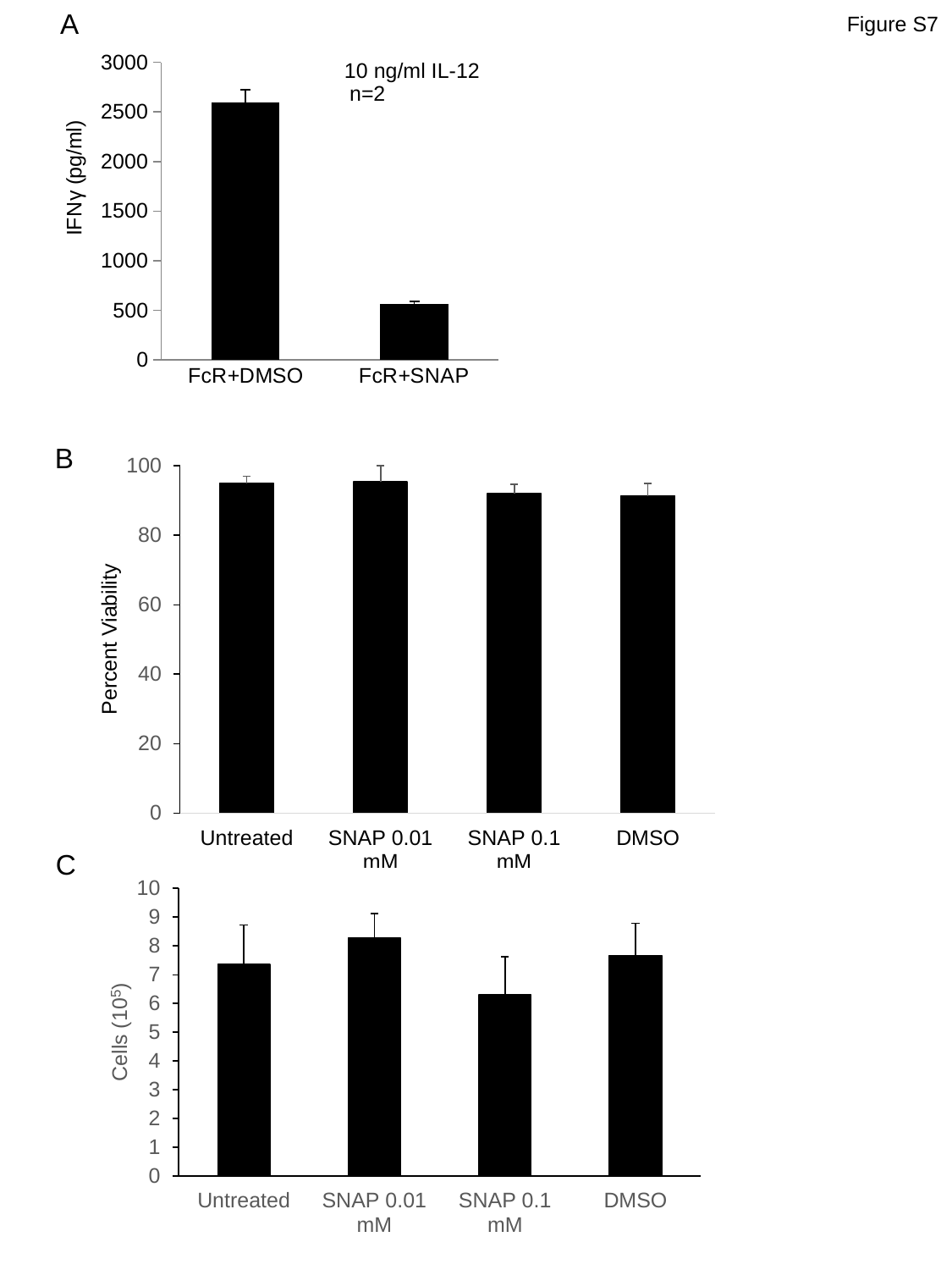
In chart B (Percent Viability), how many categories are plotted on the x axis? 4 In chart A, what is the y-axis label? IFNγ (pg/ml) In chart C (Cells), which category has the highest value? SNAP 0.01 mM In chart A (IFNγ), which category has the higher value, FcR+DMSO or FcR+SNAP? FcR+DMSO What kind of chart is chart B (Percent Viability)? bar chart In chart C (Cells), which category has the lowest value? SNAP 0.1 mM In chart C (Cells), is the value for SNAP 0.1 mM greater or less than 7? less In chart A (IFNγ), how many categories are plotted on the x axis? 2 In chart B (Percent Viability), is the value for DMSO greater or less than 80? greater In chart A, what IL-12 concentration is stated in the annotation on the chart? 10 ng/ml IL-12 In chart A (IFNγ), is the value for FcR+SNAP greater or less than 1000? less